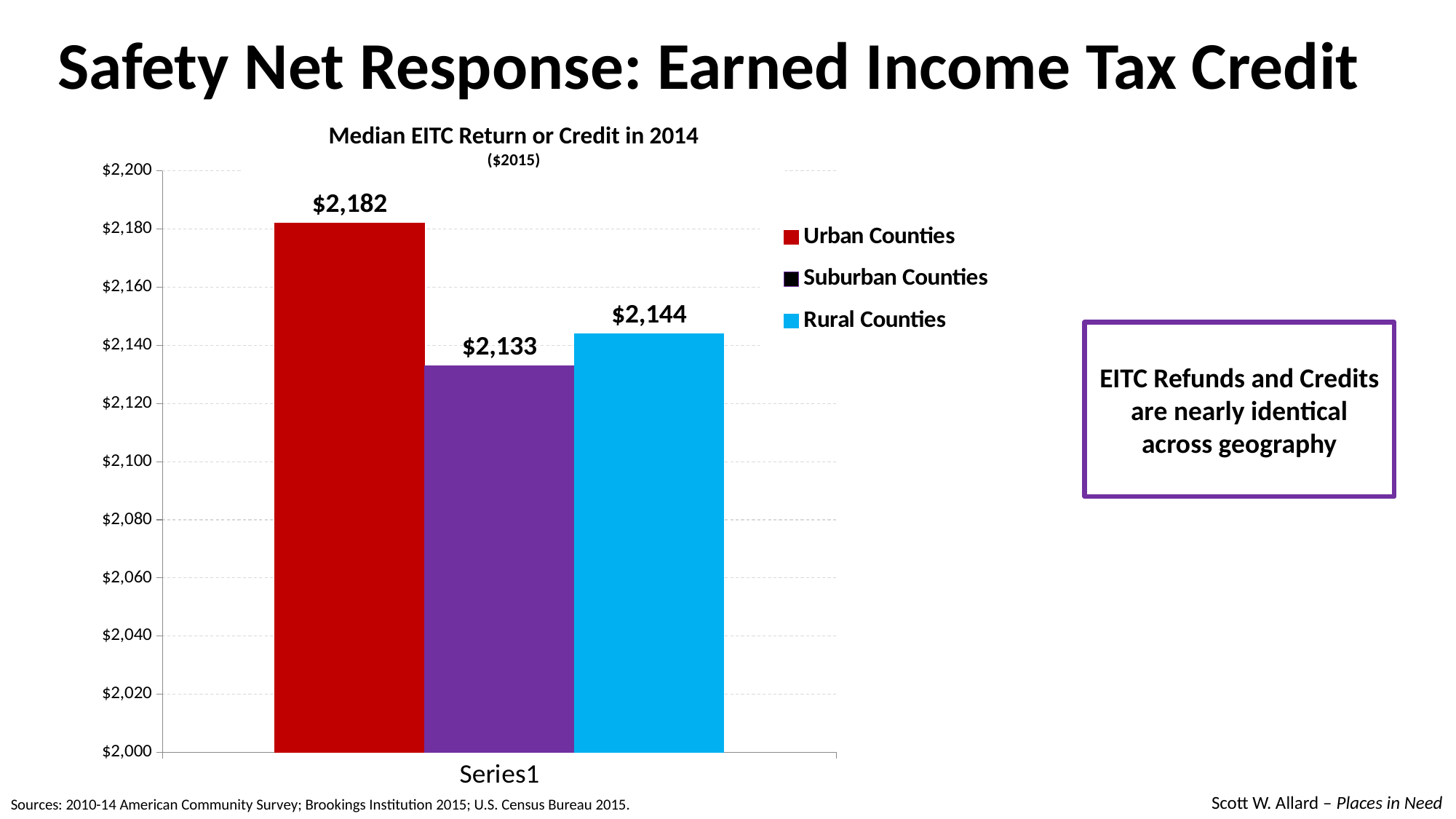
Is the value for Urban Counties greater or less than $2,160? greater Which county type has the lowest median EITC return or credit? Suburban Counties What is the median EITC return or credit for Rural Counties? $2,144 What is the title of the chart? Median EITC Return or Credit in 2014 ($2015) What is the difference between the median EITC return for Urban Counties and Suburban Counties? $49 What is the median EITC return or credit for Suburban Counties? $2,133 What is the median EITC return or credit for Urban Counties? $2,182 How many series does the legend list? 3 Which county type has the highest median EITC return or credit? Urban Counties What is the difference between the median EITC return for Rural Counties and Suburban Counties? $11 What kind of chart is shown on the slide? Bar chart Which is larger, the median EITC return for Rural Counties or Suburban Counties? Rural Counties